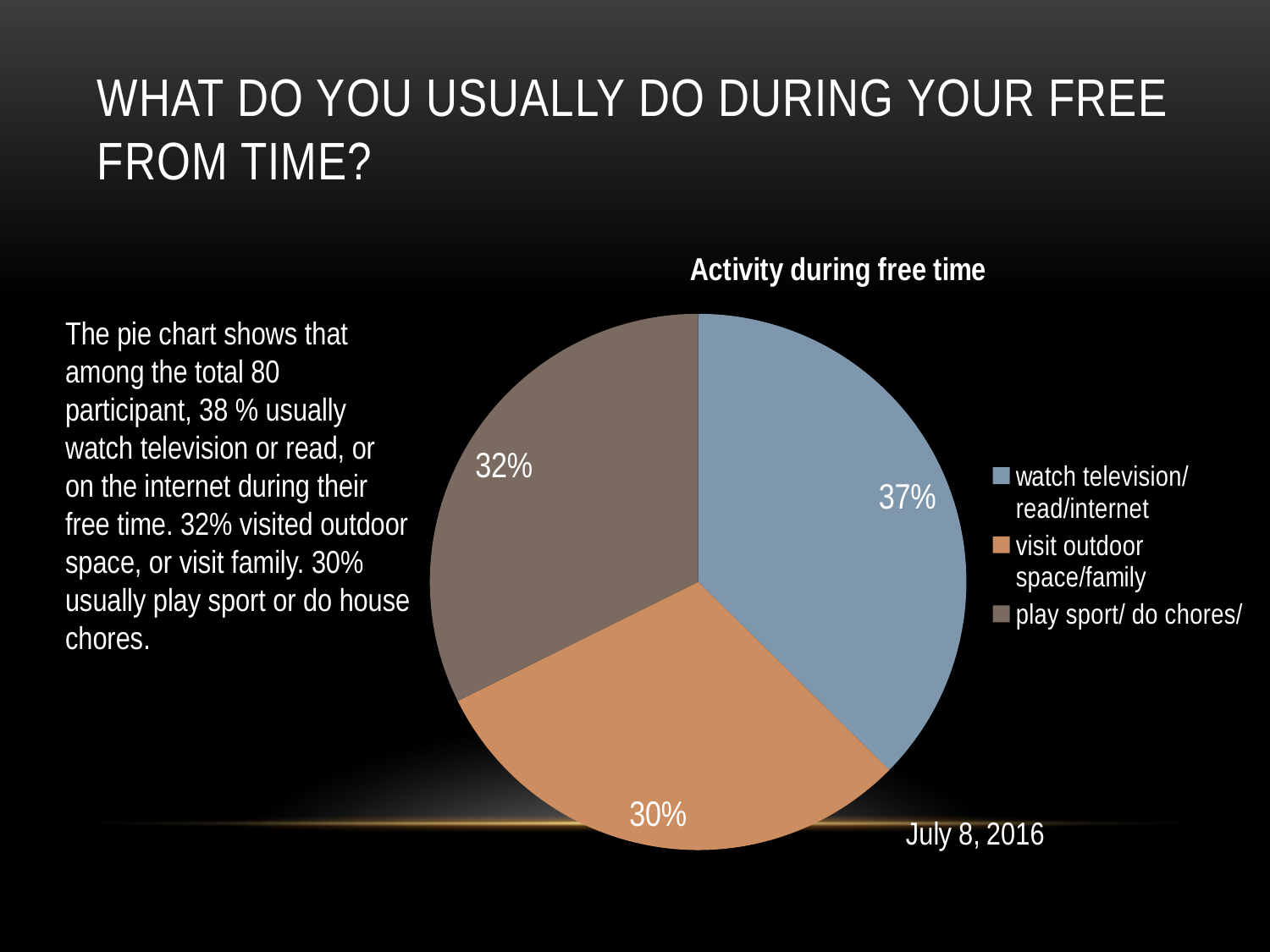
What percentage of the pie is labelled for play sport/do chores? 32% What percentage of the pie is labelled for visit outdoor space/family? 30% Which activity has the largest slice of the pie? watch television/read/internet What is the difference in percentage points between the watch television/read/internet slice and the visit outdoor space/family slice? 7 What is the title of the chart? Activity during free time What colour is the slice for visit outdoor space/family? orange What type of chart is shown on the slide? pie chart Which activity has the smallest slice of the pie? visit outdoor space/family What percentage of the pie is labelled for watch television/read/internet? 37% How many slices does the pie chart have? 3 Which slice is larger: play sport/do chores or visit outdoor space/family? play sport/do chores How many entries does the legend list? 3